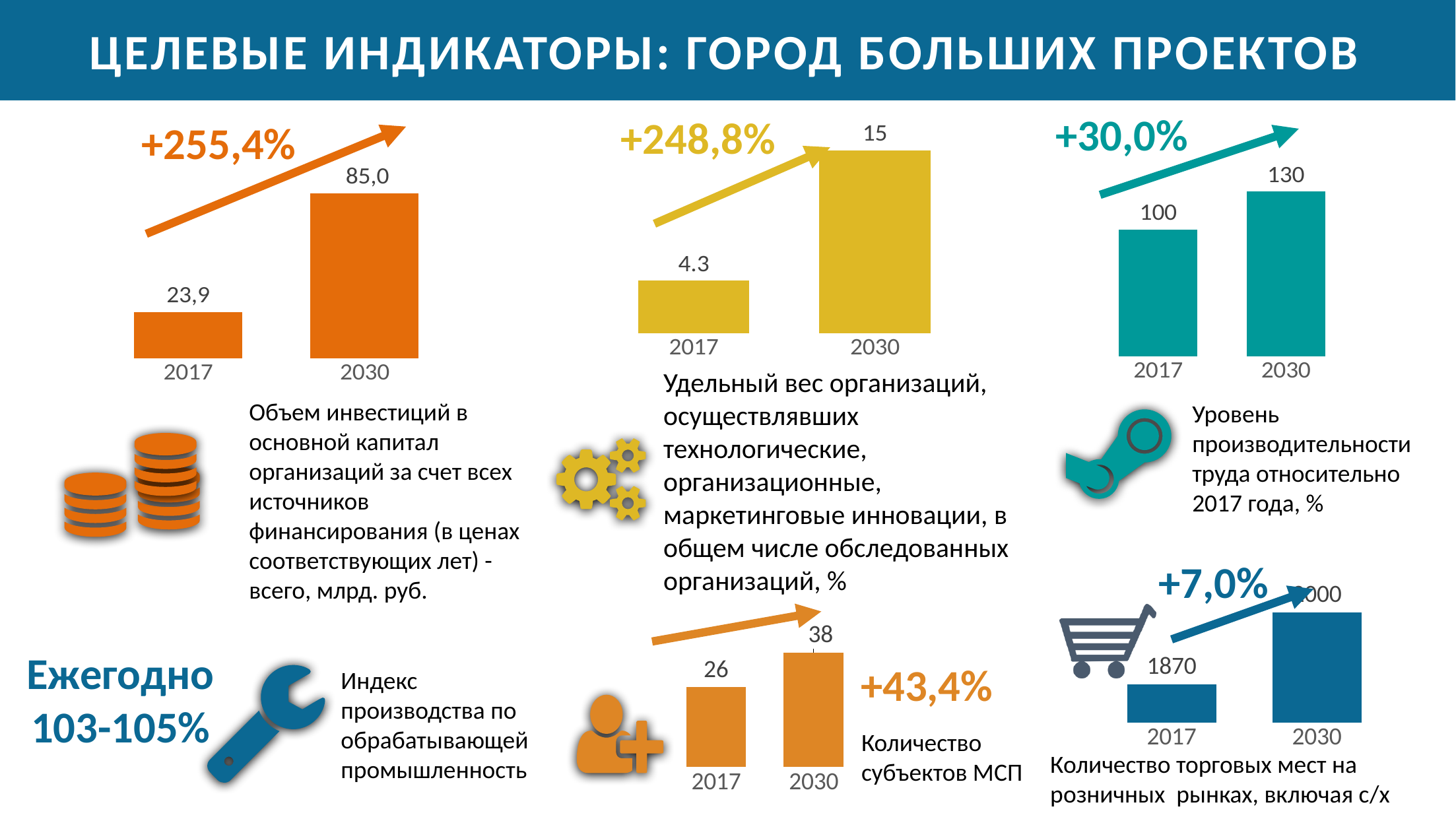
In the top-middle chart on the share of organizations implementing innovations (Удельный вес организаций), what is the value for 2017? 4.3 In the top-left chart on investment volume in fixed capital, what is the value for 2017? 23,9 In the top-left chart on investment volume in fixed capital, which year has the higher value, 2017 or 2030? 2030 In the bottom-middle chart on the number of SME entities, what is the difference between the 2030 and 2017 values? 12 In the top-middle chart on the share of organizations implementing innovations, what is the value for 2030? 15 In the top-left chart on investment volume in fixed capital (Объем инвестиций в основной капитал), what is the value for 2030? 85,0 In the top-right chart on labor productivity level (Уровень производительности труда), what is the value for 2030? 130 What kind of chart is the top-right chart on labor productivity level? bar chart In the top-right chart on labor productivity level, what is the difference between the 2030 and 2017 values? 30 In the bottom-middle chart on the number of SME entities (Количество субъектов МСП), what is the value for 2030? 38 In the bottom-right chart on the number of trading places at retail markets (Количество торговых мест), what is the value for 2017? 1870 How many categories (years) are shown in the top-middle chart on the share of organizations implementing innovations? 2